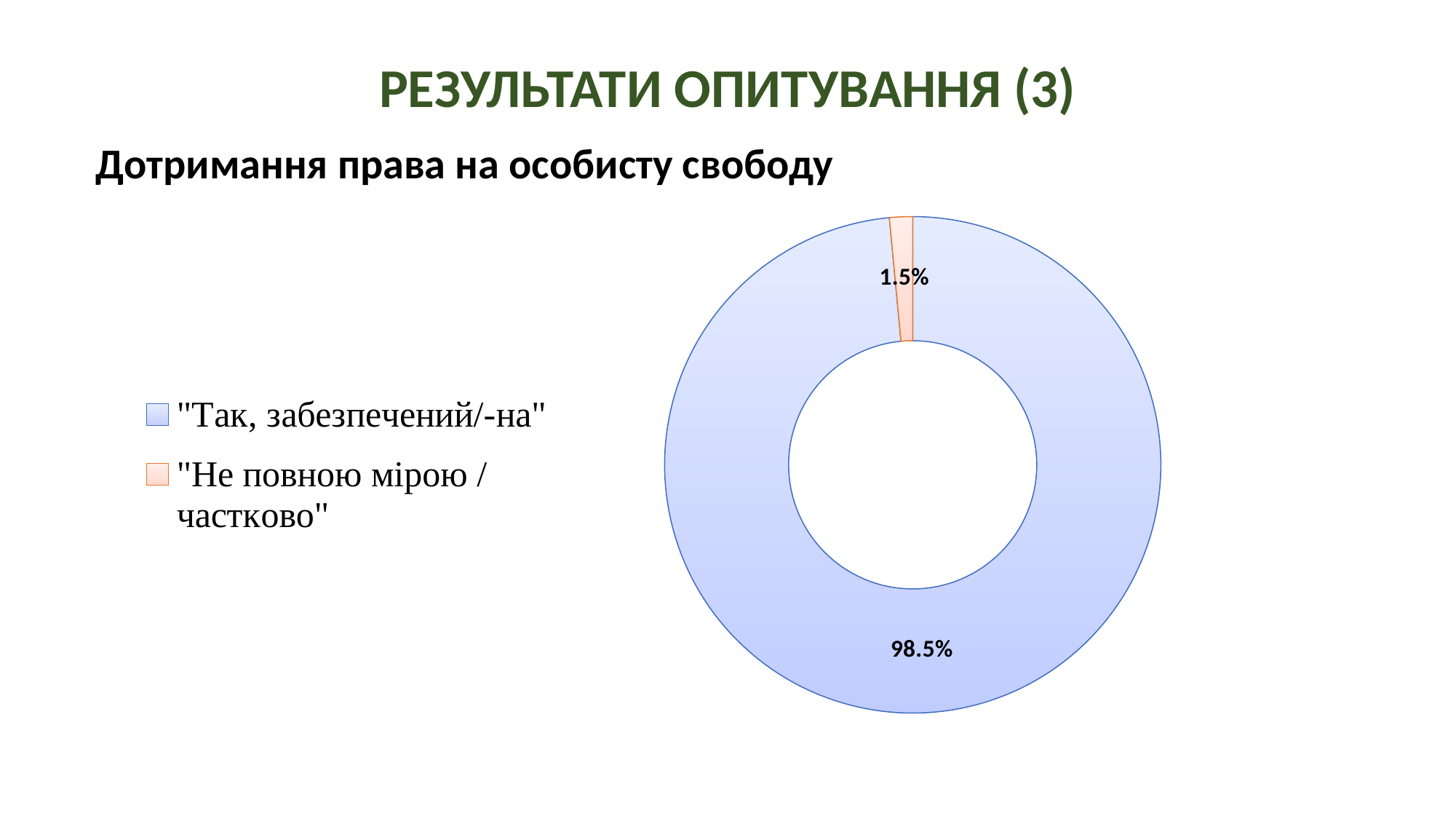
What share of respondents answered "Так, забезпечений/-на"? 98.5% Which response category has the largest share of the chart? "Так, забезпечений/-на" Which is larger: the share for "Так, забезпечений/-на" or the share for "Не повною мірою / частково"? "Так, забезпечений/-на" What is the difference in percentage points between the "Так, забезпечений/-на" share and the "Не повною мірою / частково" share? 97 percentage points How many categories does the chart show? 2 Which response category has the smallest share of the chart? "Не повною мірою / частково" What kind of chart is shown on the slide? Doughnut chart Which colour represents the "Не повною мірою / частково" category? Orange What is the heading above the chart? Дотримання права на особисту свободу What share of respondents answered "Не повною мірою / частково"? 1.5% What is the total of the two shares shown on the chart? 100% How many entries does the legend list? 2